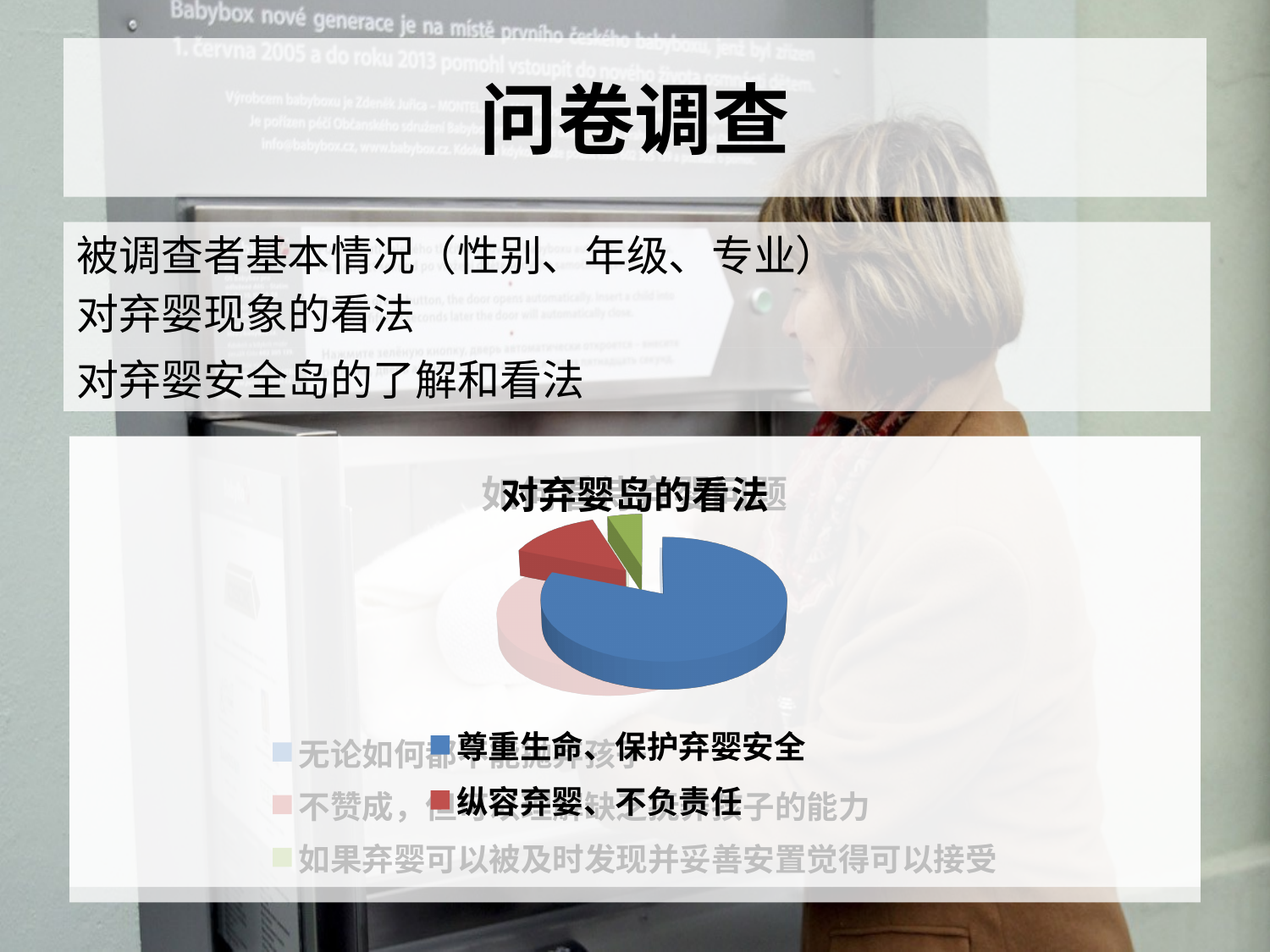
What colour is the slice for 尊重生命、保护弃婴安全? blue Which slice is larger: 尊重生命、保护弃婴安全 or 纵容弃婴、不负责任? 尊重生命、保护弃婴安全 Which category has the largest slice in the pie chart? 尊重生命、保护弃婴安全 Does the slice for 尊重生命、保护弃婴安全 take up more or less than half of the pie? more What kind of chart is shown on the slide? pie chart How many slices does the pie chart have? 3 What is the title of the pie chart? 对弃婴岛的看法